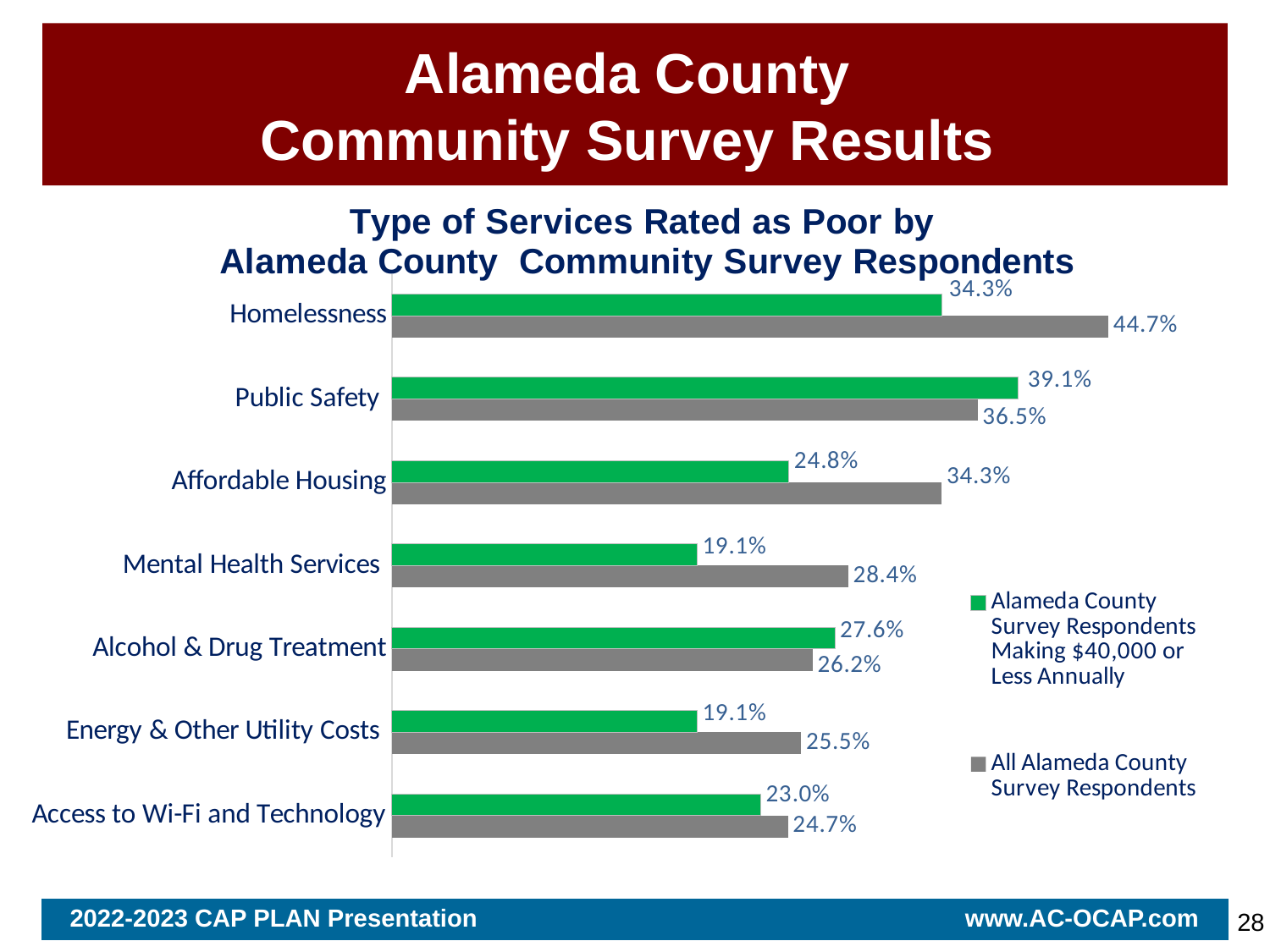
What is the difference between All Alameda County Survey Respondents and respondents making $40,000 or less for Affordable Housing? 9.5% What percentage of All Alameda County Survey Respondents rated Homelessness services as poor? 44.7% What is the difference between the two groups' values for Mental Health Services? 9.3% How many series does the legend list? 2 How many service categories are shown in the chart? 7 Which category has the lowest value for All Alameda County Survey Respondents? Access to Wi-Fi and Technology For Public Safety, which group has the larger value: respondents making $40,000 or less, or all respondents? Alameda County Survey Respondents Making $40,000 or Less Annually Which colour represents All Alameda County Survey Respondents in the chart? Gray Which category has the highest value for All Alameda County Survey Respondents? Homelessness What is the value for Affordable Housing among Alameda County Survey Respondents Making $40,000 or Less Annually? 24.8% What percentage of Alameda County Survey Respondents Making $40,000 or Less Annually rated Public Safety as poor? 39.1% What kind of chart is shown on the slide? Bar chart